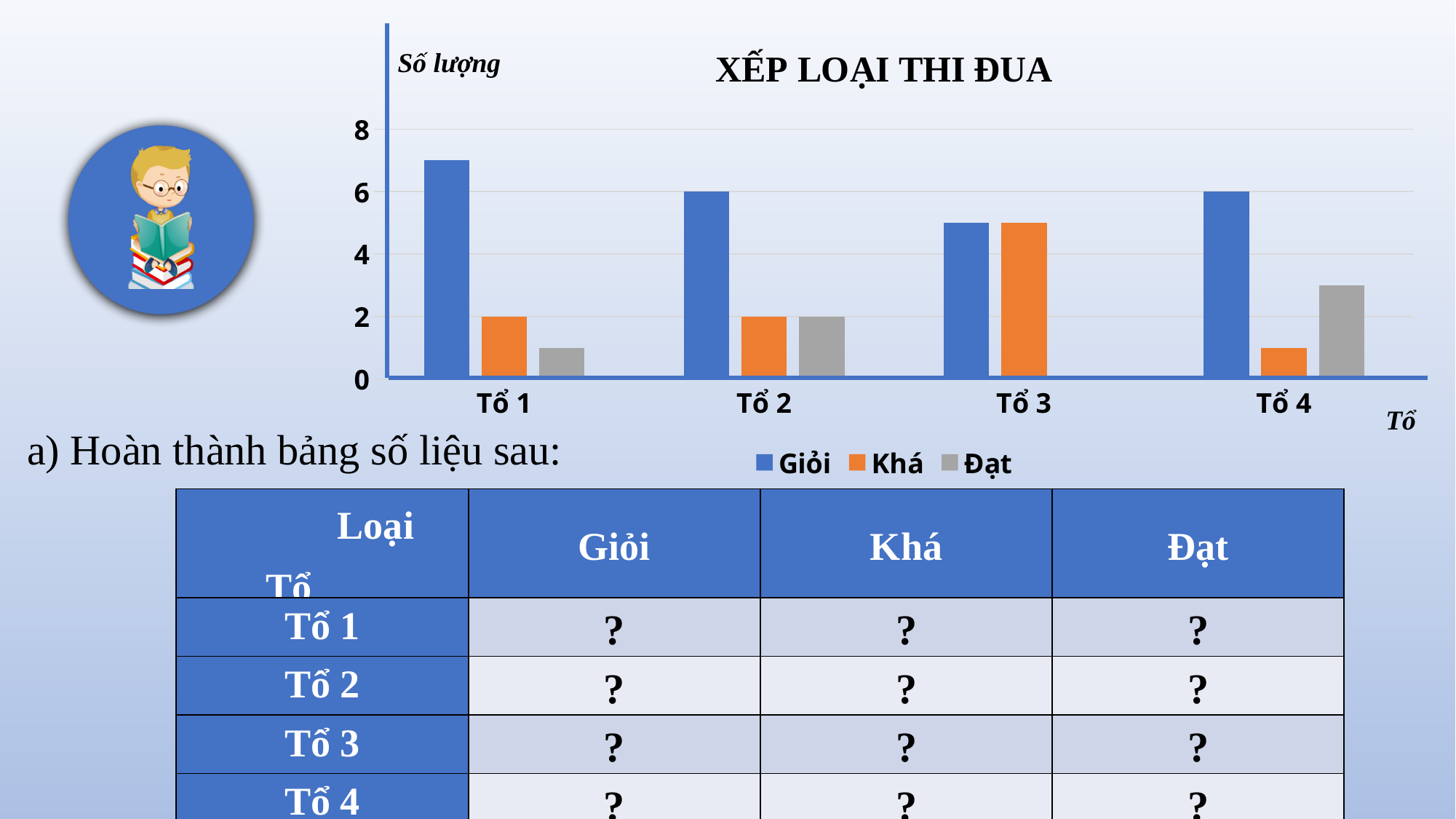
For Tổ 4, which is larger: the Khá value or the Đạt value? Đạt Is the Giỏi value for Tổ 1 greater or less than 6? greater What is the title of the chart? XẾP LOẠI THI ĐUA Which Tổ has the lowest Khá value? Tổ 4 Which Tổ has the highest Giỏi value? Tổ 1 Is the Khá value for Tổ 3 greater or less than 4? greater What is the Giỏi value for Tổ 4? 6 What is the Khá value for Tổ 1? 2 How many groups (Tổ) are shown on the x axis of the chart? 4 How many series does the legend of the chart list? 3 What kind of chart is shown on the slide? bar chart What is the Giỏi value for Tổ 2? 6